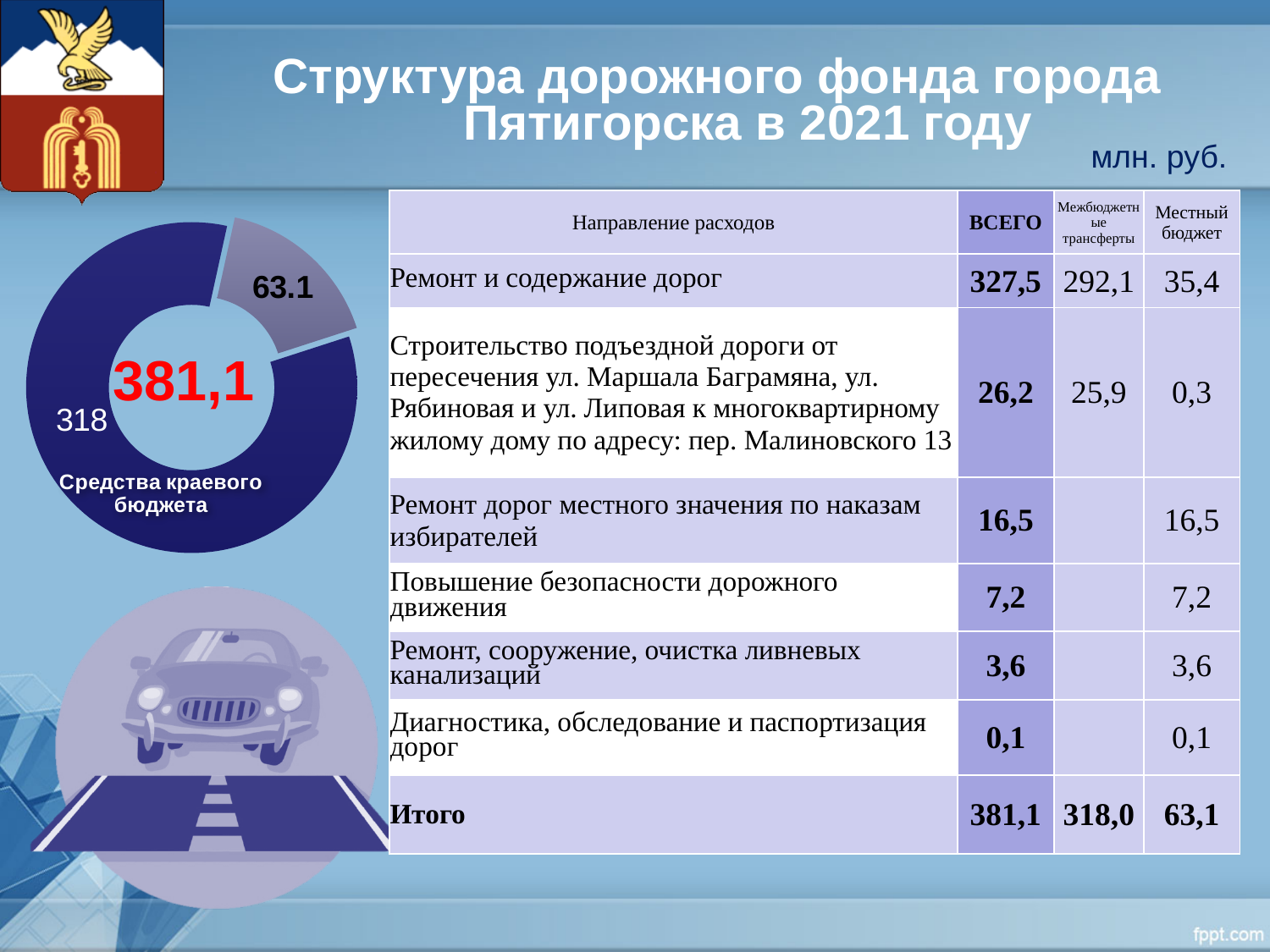
How many slices does the doughnut chart have? 2 What is the title of the slide containing the doughnut chart? Структура дорожного фонда города Пятигорска в 2021 году What kind of chart is shown on the left of the slide? doughnut (pie) chart In the doughnut chart, what value is shown for Средства краевого бюджета? 318 In the doughnut chart, what value is shown for the smaller slice? 63.1 What unit of measurement is stated on the slide for the chart values? млн. руб. In the doughnut chart, which is larger: the slice for Средства краевого бюджета or the slice labelled 63.1? Средства краевого бюджета What is the difference between the two slice values in the doughnut chart (318 and 63.1)? 254.9 Which slice of the doughnut chart is the smallest? the slice labelled 63.1 Which slice of the doughnut chart is the largest? Средства краевого бюджета (318) What total value is shown in the centre of the doughnut chart? 381,1